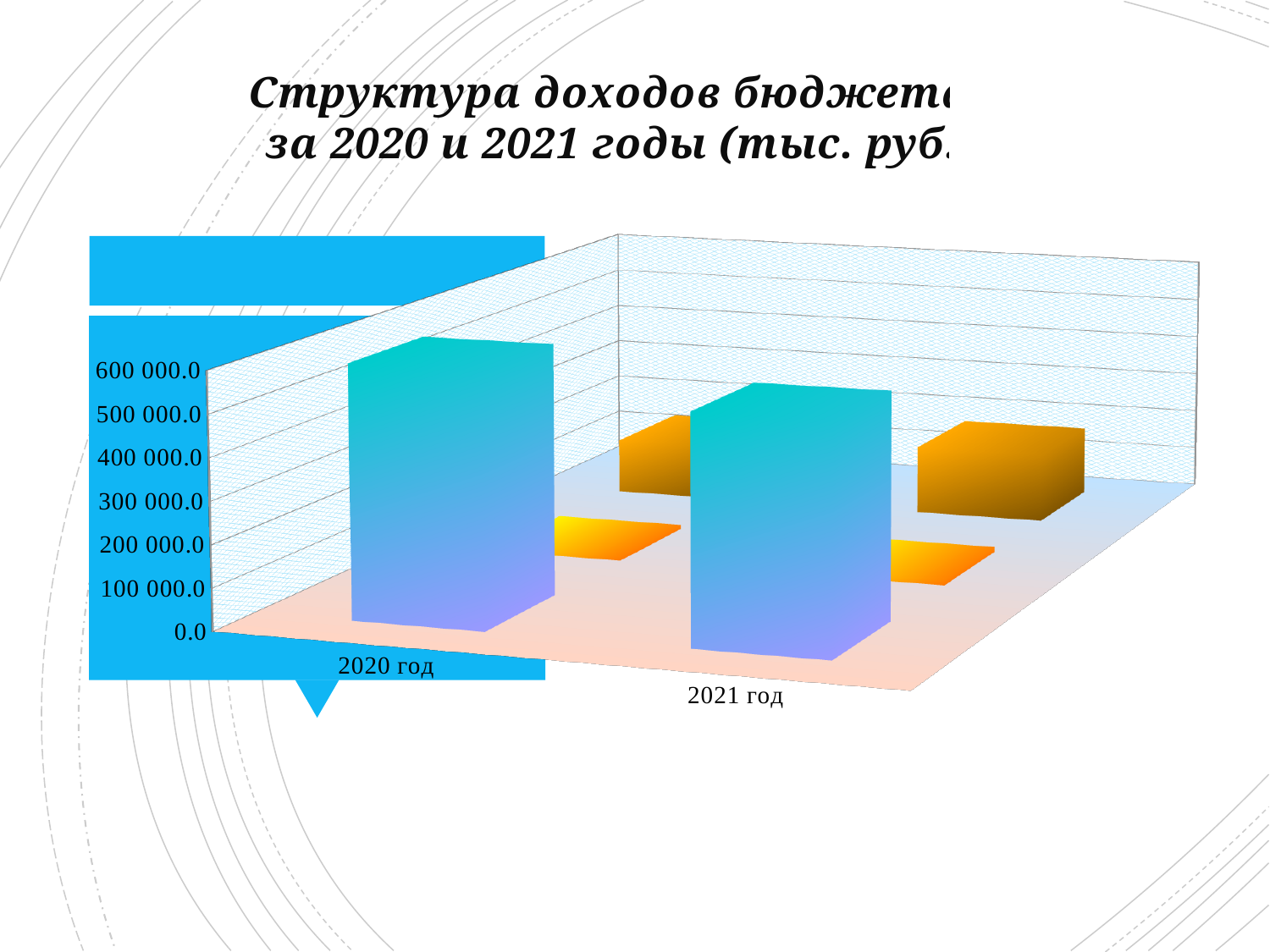
Which year has the taller blue bar, 2020 год or 2021 год? 2020 год How many bars are plotted for each year in the chart? 3 Is the value of the yellow bar for 2020 год greater or less than 300 000? less Does the value of the blue bar rise or fall from 2020 год to 2021 год? fall What kind of chart is shown on the slide? bar chart Which bar is the tallest in the whole chart? the blue bar for 2020 год How many year categories are shown on the x axis of the chart? 2 Is the value of the yellow bar for 2021 год greater or less than 300 000? less What is the highest value shown on the vertical axis of the chart? 600 000.0 Is the value of the blue bar for 2020 год greater or less than 300 000? greater Which years are compared in the chart? 2020 год and 2021 год